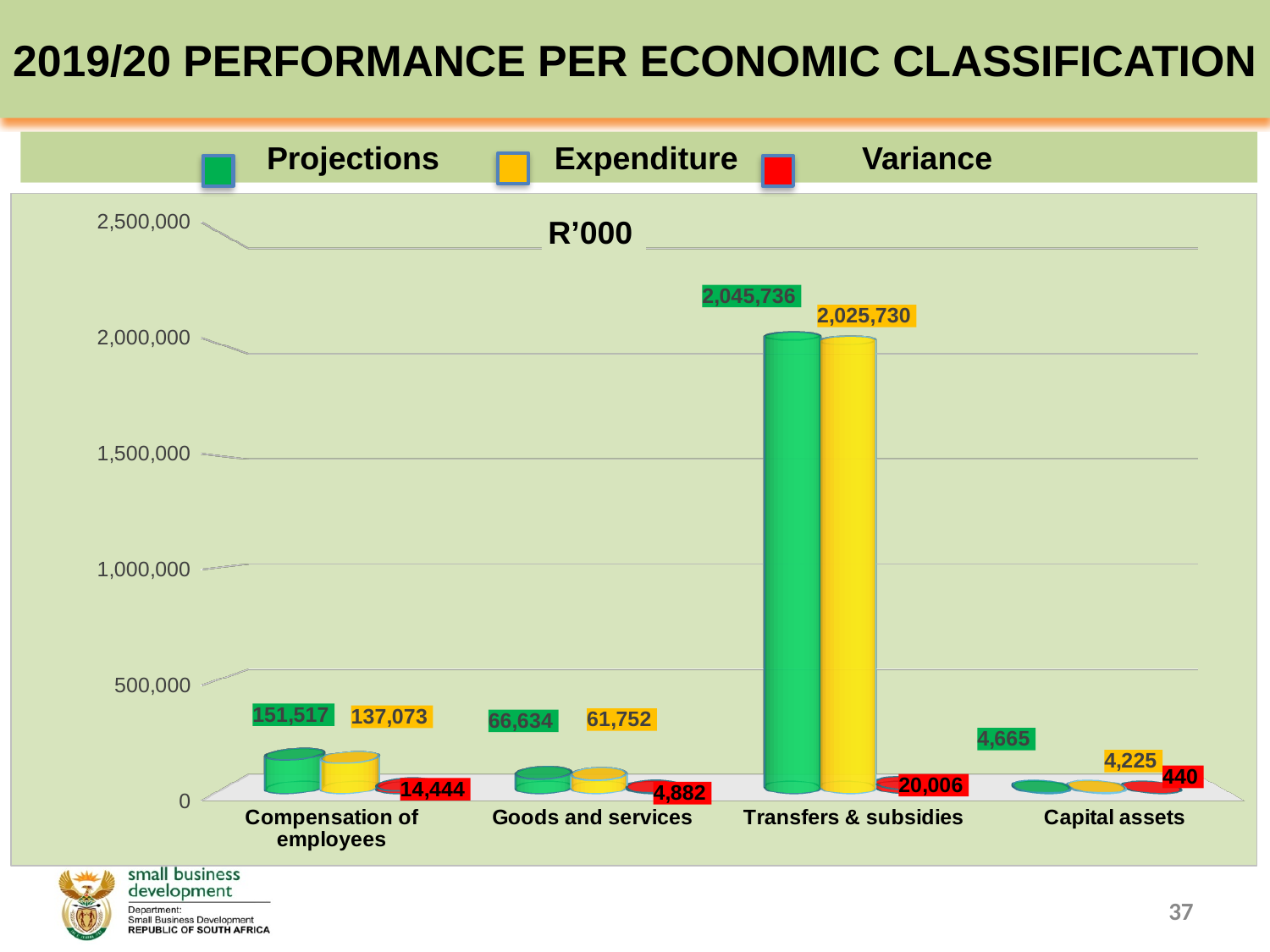
How many categories are shown on the x axis? 4 Is the Expenditure value for Transfers & subsidies greater or less than 2,000,000? greater Which is larger: the Projections value for Goods and services or the Expenditure value for Goods and services? Projections (66,634) Which category has the lowest Expenditure value? Capital assets Which category has the highest Projections value? Transfers & subsidies What is the difference between Projections and Expenditure for Transfers & subsidies? 20,006 What is the Variance value for Goods and services? 4,882 How many series does the legend list? 3 What kind of chart is shown on the slide? Bar chart What is the Expenditure value for Compensation of employees? 137,073 What is the Expenditure value for Capital assets? 4,225 What is the Projections value for Transfers & subsidies? 2,045,736